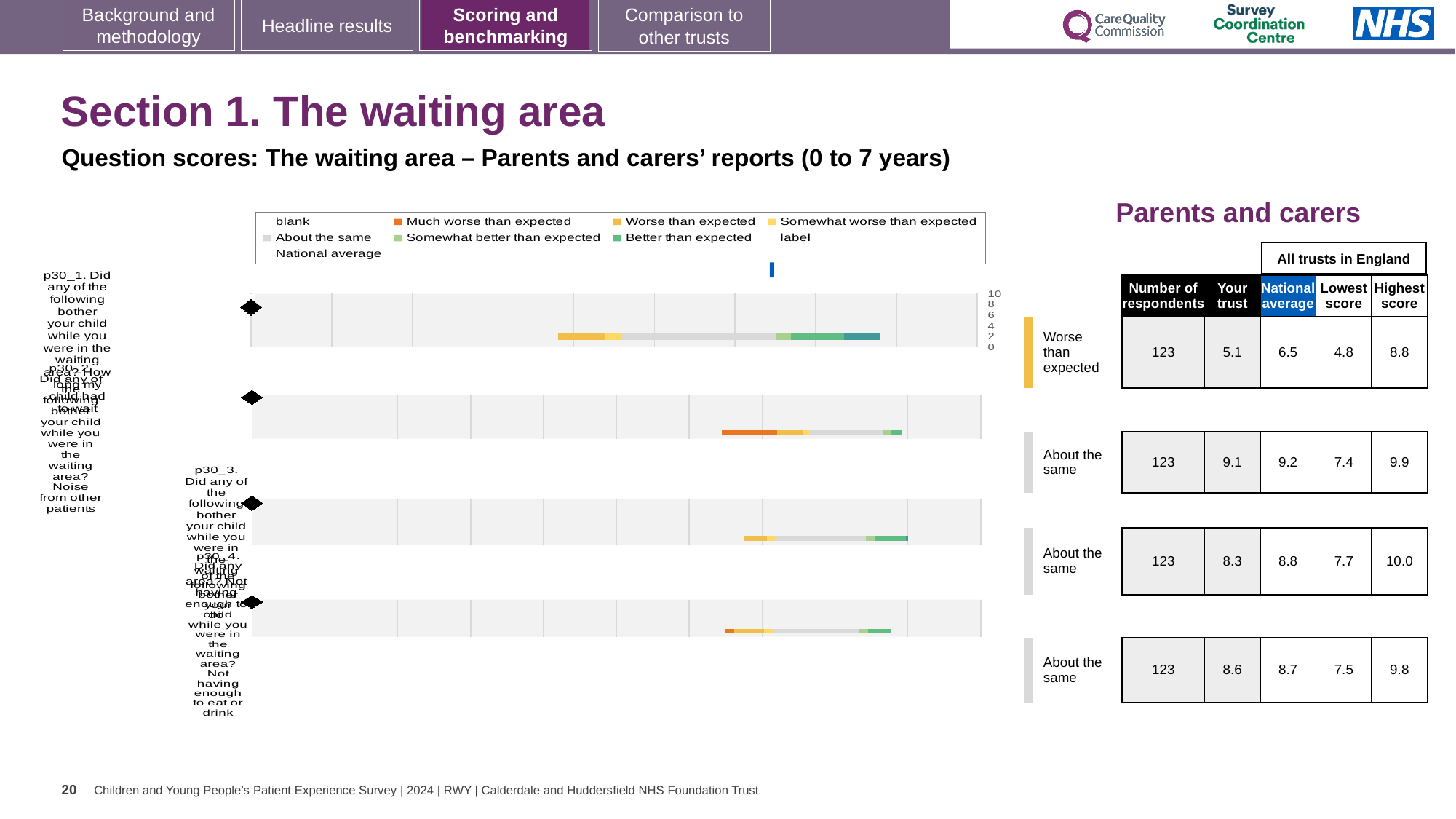
What is the highest score across all trusts in England for the third row? 10.0 In the table on the right, what is the number of respondents for each row? 123 How many question rows (bars) does the chart on the left show? 4 For the first row, what is the difference between the national average (6.5) and the 'Your trust' score (5.1)? 1.4 Which row in the table has the lowest 'Your trust' score? the first row (5.1) For the first row, which is larger: the 'Your trust' score or the national average? national average What benchmark rating is given to the first question row? Worse than expected What kind of chart is shown on the left of the slide? bar chart What colour is used in the legend for 'Much worse than expected'? orange In the table on the right, what is the 'Your trust' score for the first row (the first question in the chart)? 5.1 Which row in the table has the highest 'Your trust' score? the second row (9.1) In the table on the right, what is the national average for the first row? 6.5